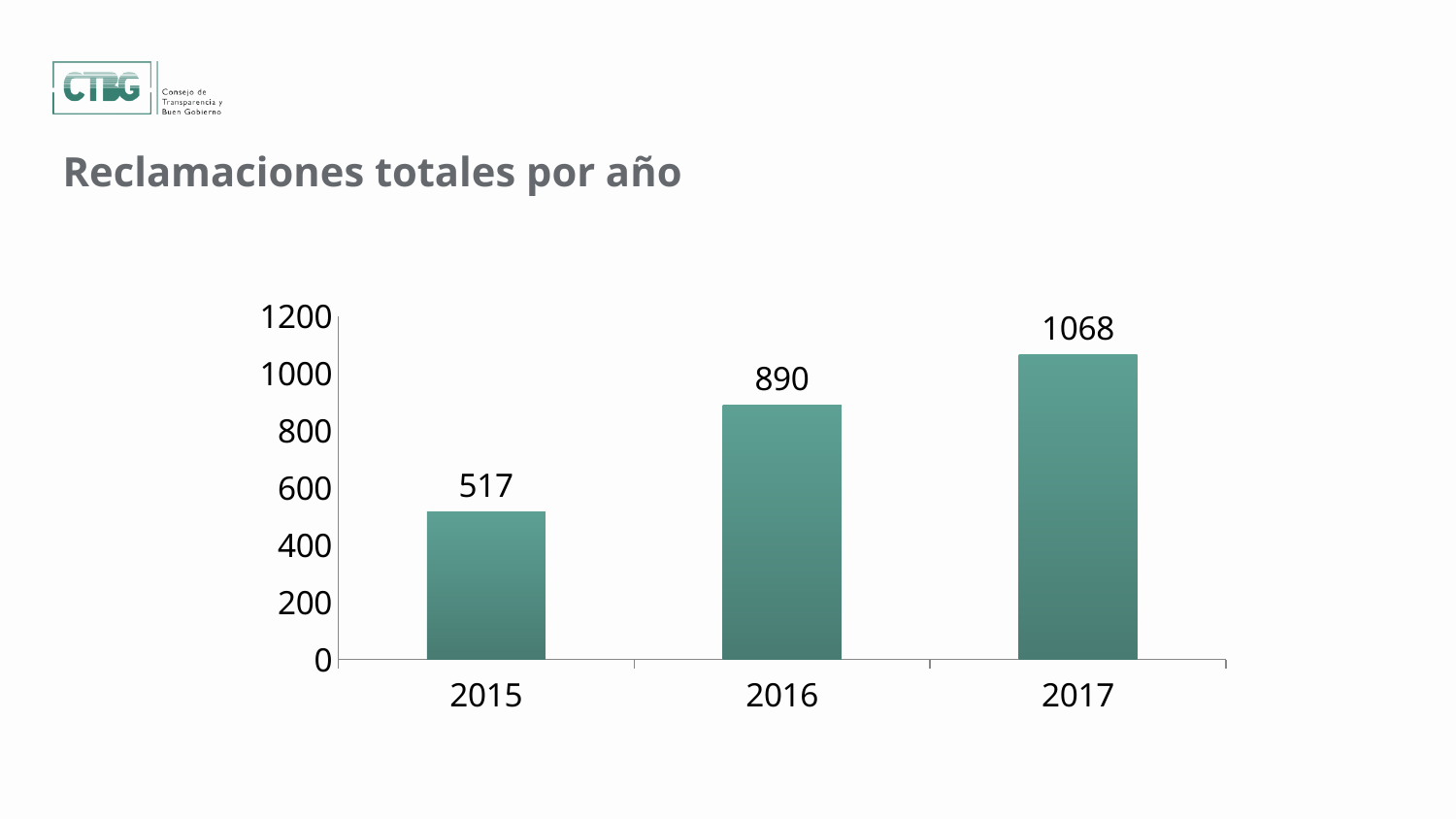
Which year has the lowest value? 2015 Is the value for 2017 greater or less than 1000? greater Which year has the highest value? 2017 What is the difference between the values for 2016 and 2015? 373 What is the difference between the values for 2017 and 2016? 178 What is the value for 2016? 890 Which is larger, the value for 2015 or the value for 2016? 2016 What kind of chart is shown on the slide? bar chart Do the values rise or fall from 2015 to 2017? rise What is the value for 2017? 1068 How many years are shown on the x axis? 3 What is the value for 2015? 517